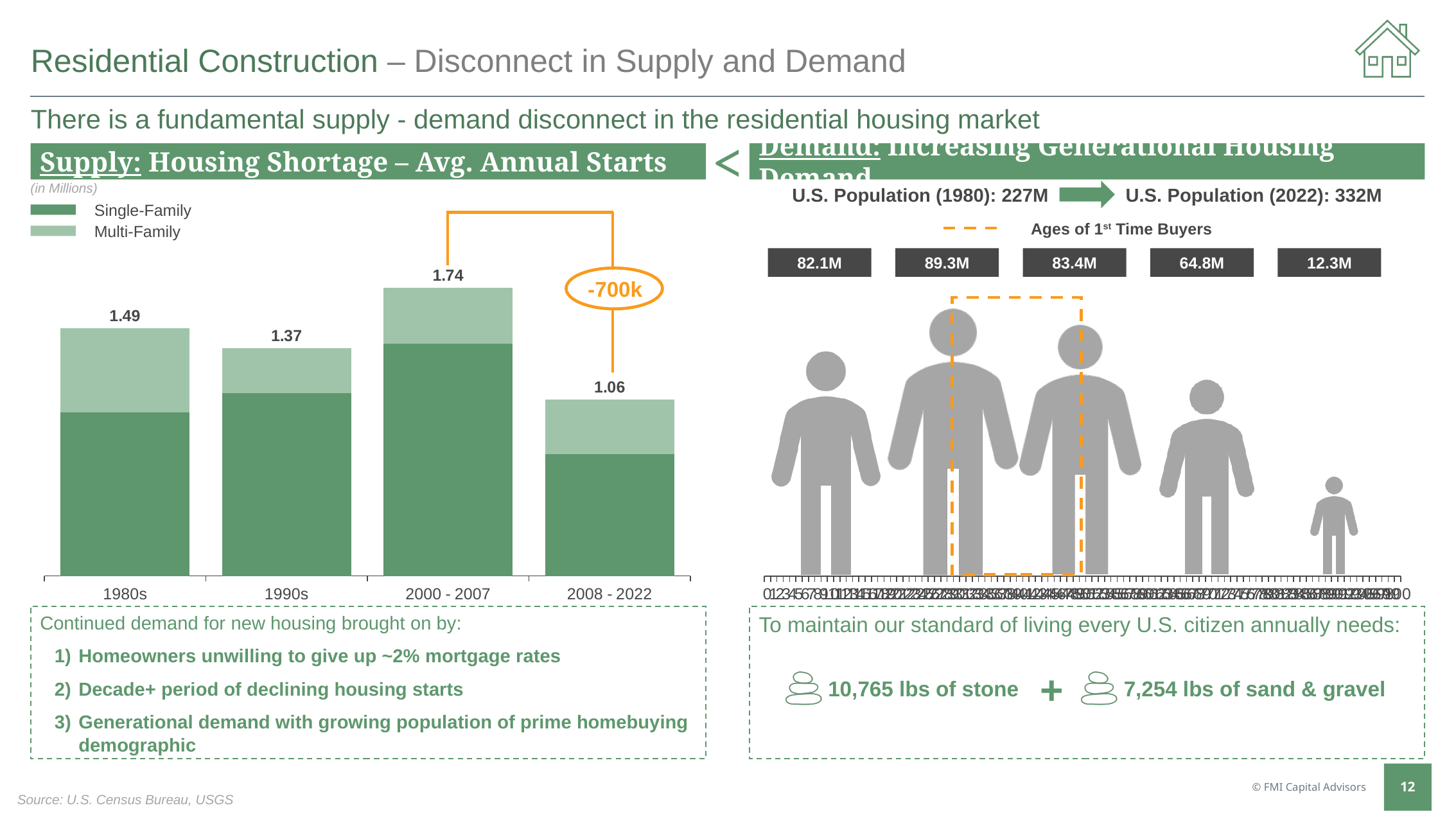
In the Supply: Housing Shortage – Avg. Annual Starts chart, what are the two series named in the legend? Single-Family and Multi-Family In the Supply: Housing Shortage – Avg. Annual Starts chart, what is the total value labeled for 2000 - 2007? 1.74 In the Supply: Housing Shortage – Avg. Annual Starts chart, does the total rise or fall from 2000 - 2007 to 2008 - 2022? Fall In the Supply: Housing Shortage – Avg. Annual Starts chart, how many time periods are shown on the x axis? 4 In the Supply: Housing Shortage – Avg. Annual Starts chart, what is the difference between the total for 2000 - 2007 and the total for 2008 - 2022? 0.68 In the Supply: Housing Shortage – Avg. Annual Starts chart, which period has the larger total, the 1980s or the 1990s? 1980s What kind of chart is the Supply: Housing Shortage – Avg. Annual Starts chart? Stacked bar chart In the Supply: Housing Shortage – Avg. Annual Starts chart, which period has the lowest total average annual starts? 2008 - 2022 In the Supply: Housing Shortage – Avg. Annual Starts chart, what is the total average annual starts value labeled for the 1980s? 1.49 In the Supply: Housing Shortage – Avg. Annual Starts chart, what is the total value labeled for 2008 - 2022? 1.06 In the Supply: Housing Shortage – Avg. Annual Starts chart, which period has the highest total average annual starts? 2000 - 2007 In the Supply: Housing Shortage – Avg. Annual Starts chart, how many series does the legend list? 2